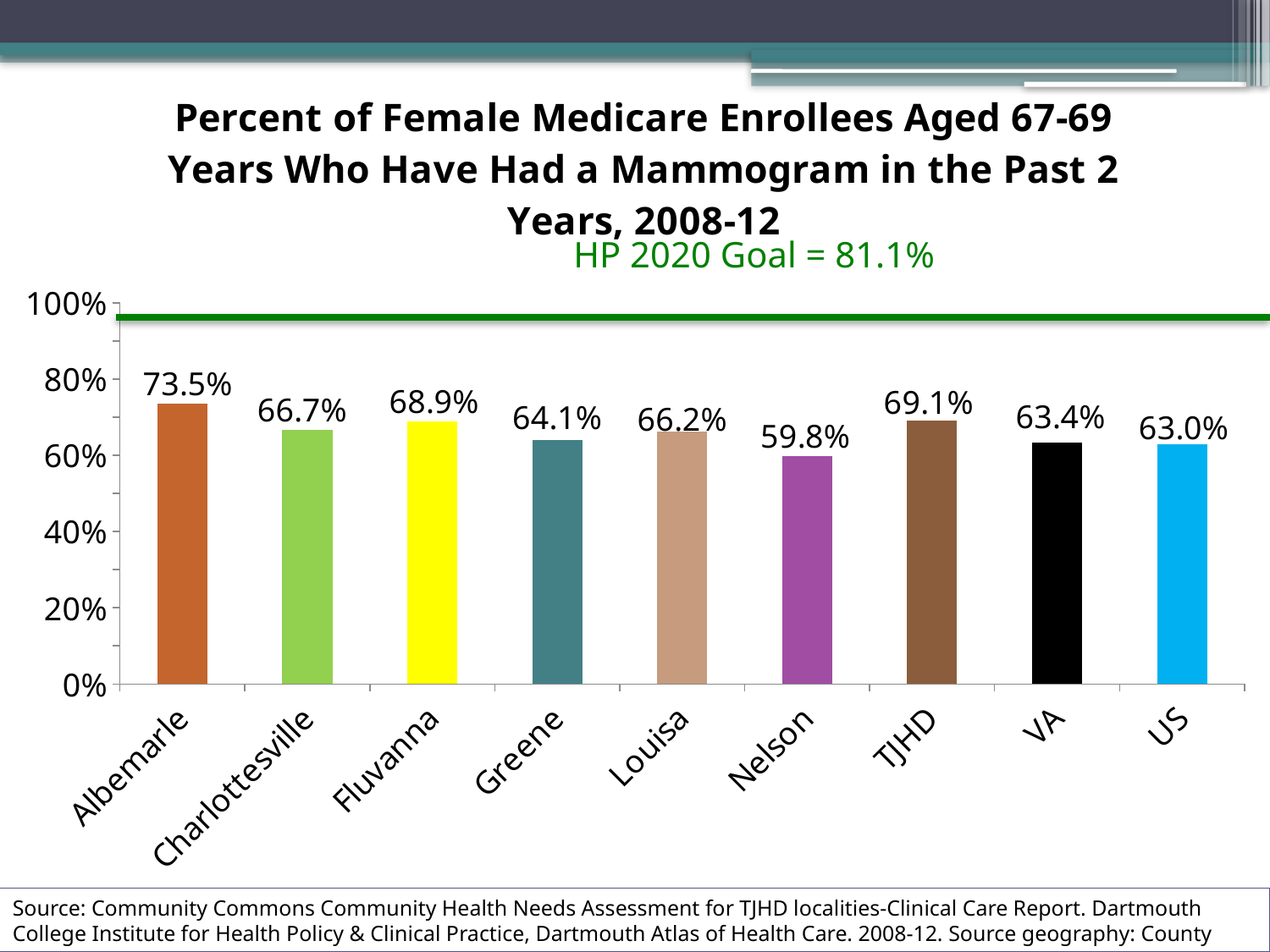
What is the difference between the values for Albemarle and Nelson? 13.7% Which category has the highest value? Albemarle How many categories are shown on the x axis? 9 What is the HP 2020 Goal stated on the slide? 81.1% What is the value for US? 63.0% What is the difference between the values for TJHD and US? 6.1% Which is larger, the value for Fluvanna or the value for Greene? Fluvanna What is the value for Albemarle? 73.5% What kind of chart is shown on the slide? Bar chart Which category has the lowest value? Nelson What is the value for Nelson? 59.8% What is the value for TJHD? 69.1%